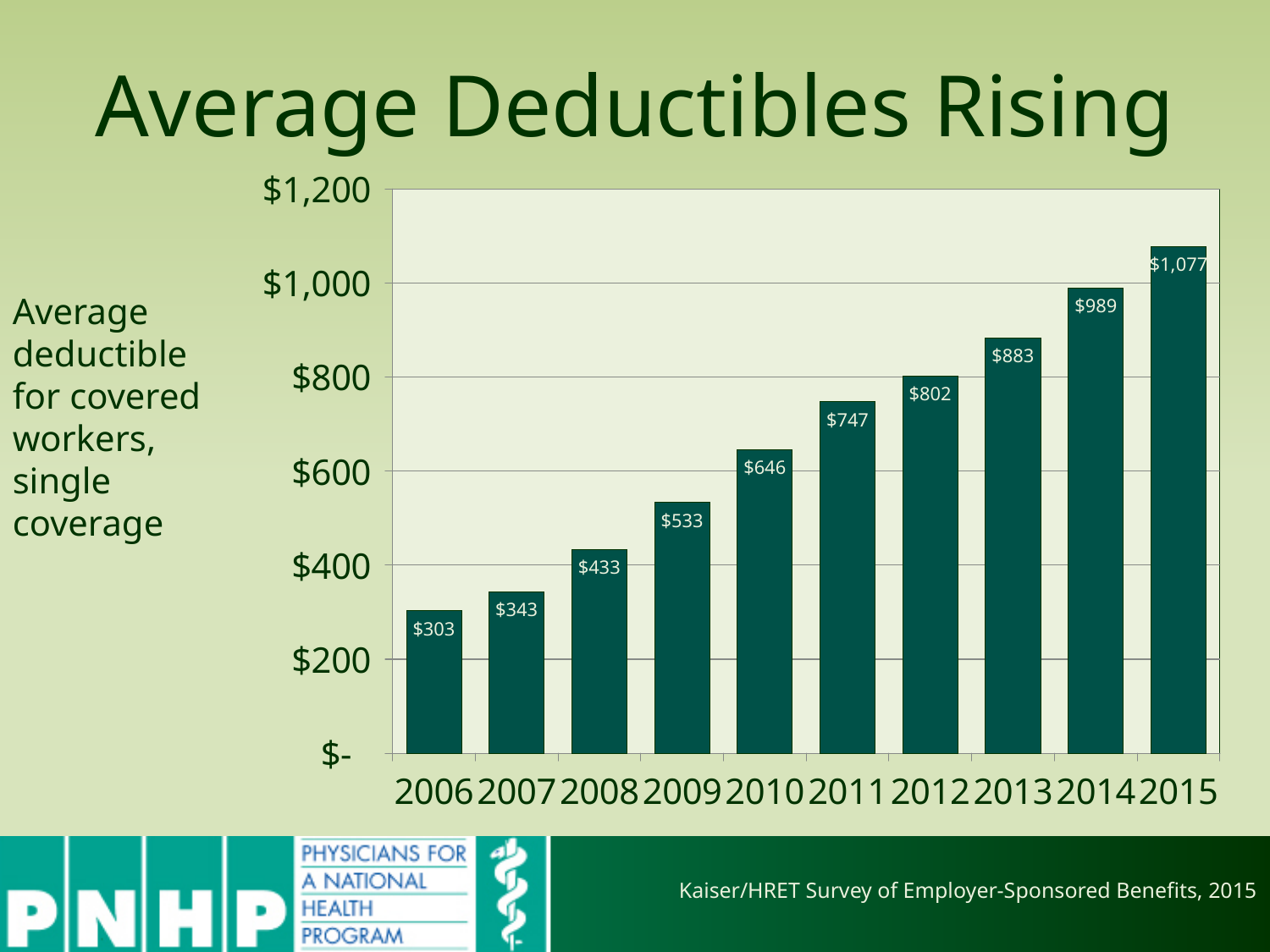
Which year has the lowest average deductible? 2006 What kind of chart is shown on the slide? Bar chart Do the average deductibles rise or fall from 2006 to 2015? Rise What is the average deductible for 2011? $747 Which year has a larger average deductible, 2008 or 2012? 2012 What is the average deductible for 2006? $303 What is the average deductible for 2015? $1,077 Is the value for 2013 greater or less than $800? greater How many years are shown on the chart? 10 What is the difference between the average deductible in 2015 and in 2006? $774 Which year has the highest average deductible? 2015 What is the difference between the average deductible in 2010 and in 2009? $113